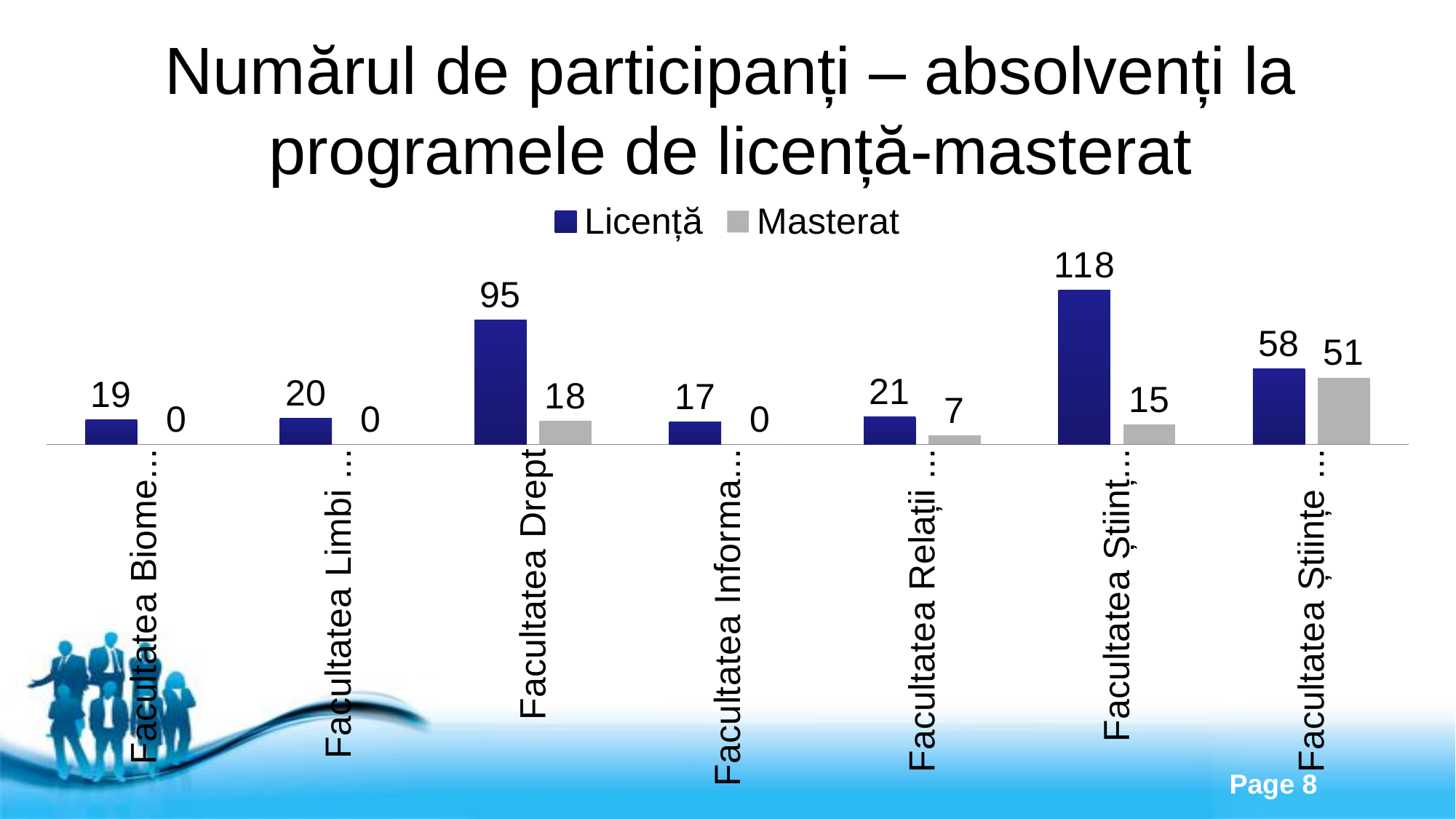
What are the two series named in the legend? Licență and Masterat What is the highest Masterat value shown in the chart? 51 What is the Masterat value for Facultatea Drept? 18 For Facultatea Drept, which is larger, the Licență value or the Masterat value? Licență What is the lowest Licență value shown in the chart? 17 How many faculties (categories) are shown on the x axis? 7 What is the Licență value for Facultatea Drept? 95 What is the difference between the Licență and Masterat values for Facultatea Drept? 77 How many series does the legend list? 2 What type of chart is shown on the slide? bar chart How many categories have a Masterat value of 0? 3 What is the highest Licență value shown in the chart? 118